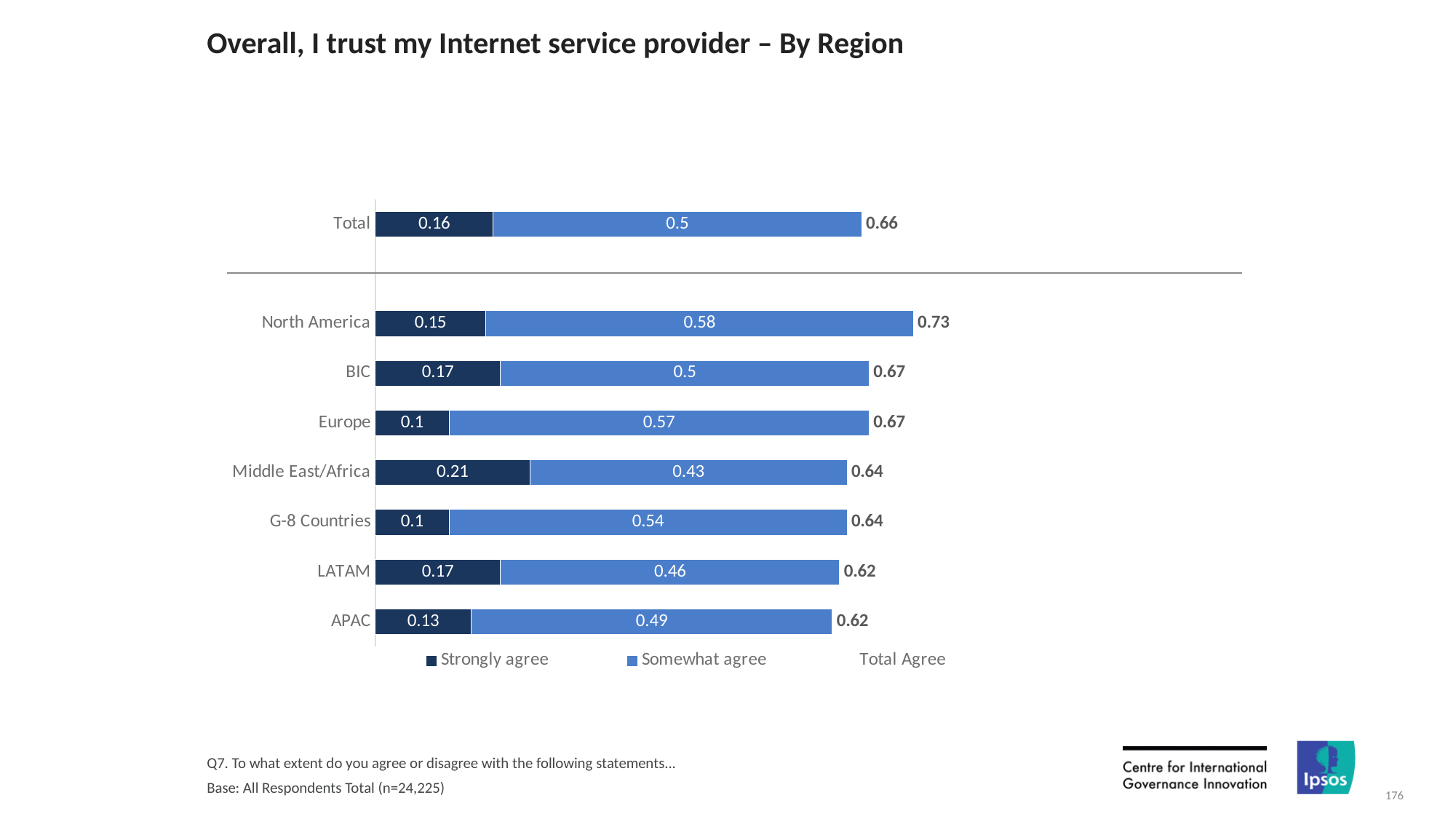
What is the difference between the Total Agree values for North America and APAC? 0.11 What is the title of the chart? Overall, I trust my Internet service provider – By Region Which is larger, the Somewhat agree value for Europe or for BIC? Europe How many categories (including Total) are shown on the chart? 8 What is the Strongly agree value for Middle East/Africa? 0.21 Which region has the highest Total Agree value? North America What is the Total Agree value for LATAM? 0.62 Which region has the lowest Somewhat agree value? Middle East/Africa What kind of chart is shown on the slide? Stacked bar chart Which region has the highest Strongly agree value? Middle East/Africa What is the Somewhat agree value for North America? 0.58 How many series does the legend list? 3